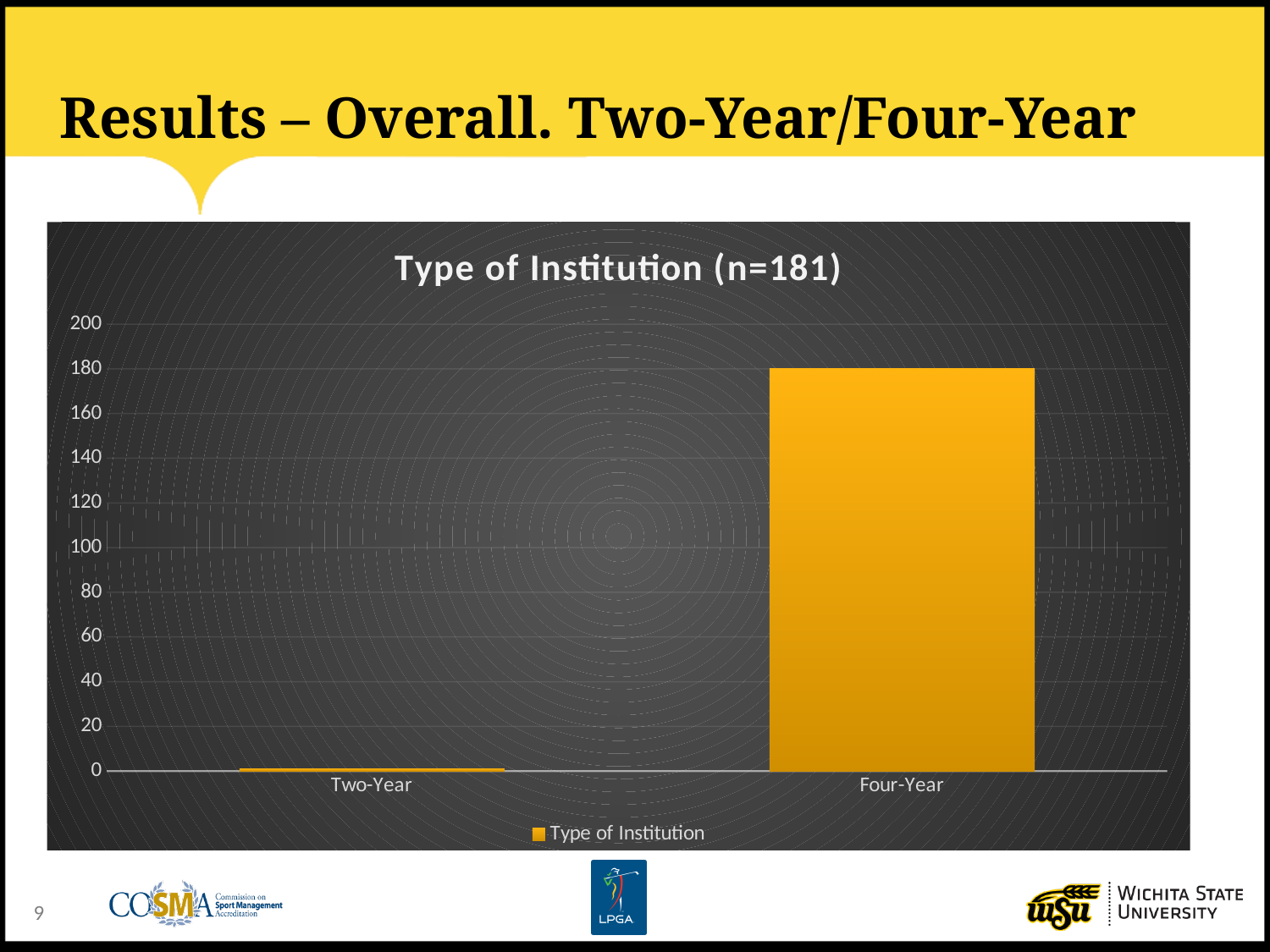
Is the value for Four-Year greater or less than 200? less What is the title of the chart? Type of Institution (n=181) Is the value for Two-Year greater or less than 20? less How many series does the legend list? 1 Which is larger, the value for Two-Year or the value for Four-Year? Four-Year How many categories are shown on the x axis of the chart? 2 Which category has the highest value? Four-Year Which category has the lowest value? Two-Year Is the value for Four-Year greater or less than 160? greater What is the legend entry shown below the chart? Type of Institution What value does the Four-Year bar reach on the y axis? 180 What kind of chart is shown on the slide? bar chart